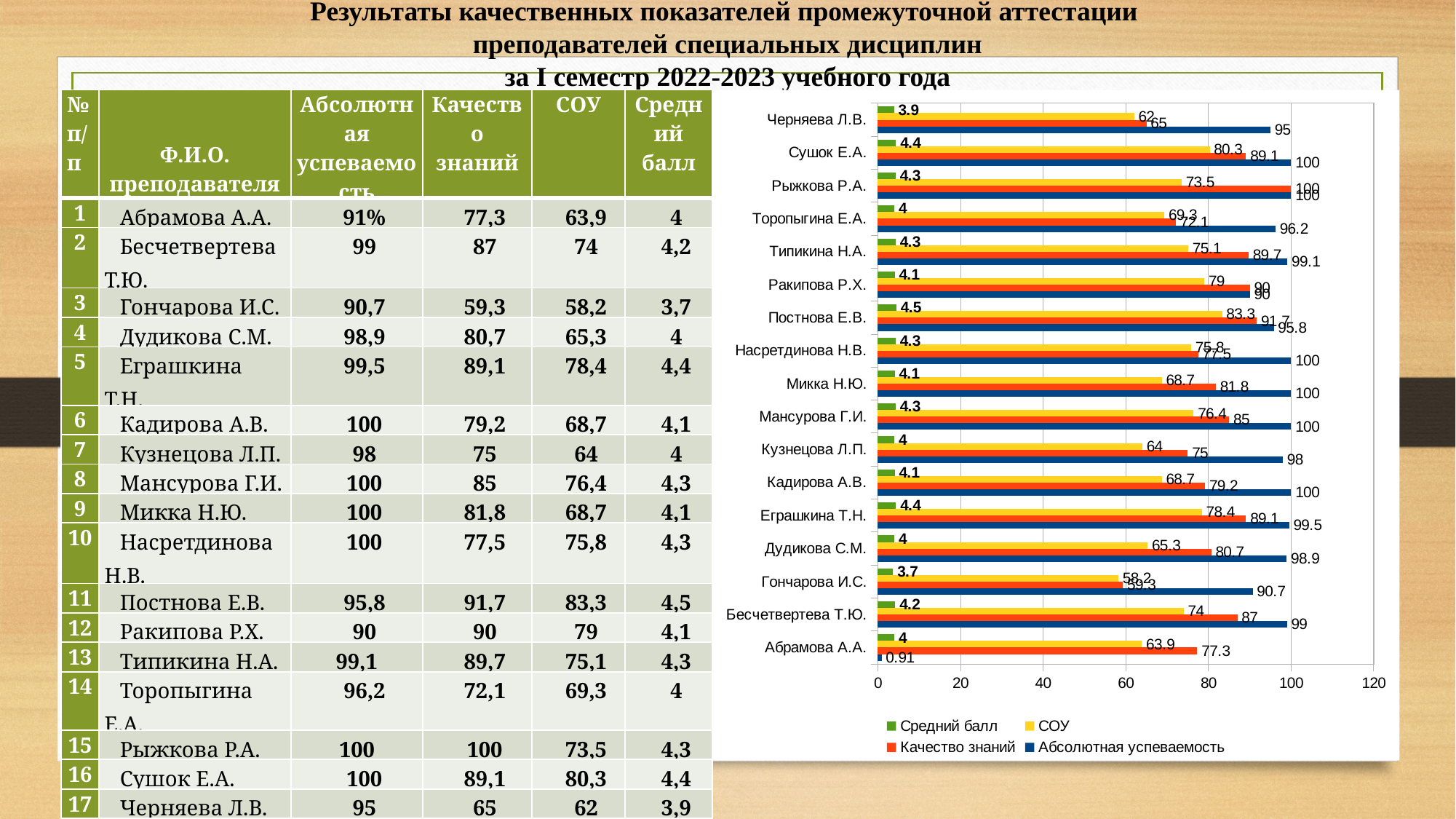
What colour are the Абсолютная успеваемость bars in the chart? blue In the chart, what is the СОУ value for Постнова Е.В.? 83.3 In the chart, what is the Абсолютная успеваемость value for Торопыгина Е.А.? 96.2 What kind of chart is shown on the slide? bar chart Which teacher has the lowest Средний балл in the chart? Гончарова И.С. In the chart, what is the difference between Качество знаний and СОУ for Черняева Л.В.? 3 In the chart, what is the Абсолютная успеваемость value shown for Абрамова А.А.? 0.91 How many series does the chart legend list? 4 Which teacher has the highest Средний балл in the chart? Постнова Е.В. In the chart, who has the higher СОУ value: Мансурова Г.И. or Кузнецова Л.П.? Мансурова Г.И. In the chart, what is the Качество знаний value for Сушок Е.А.? 89.1 How many teachers (categories) are plotted in the chart? 17